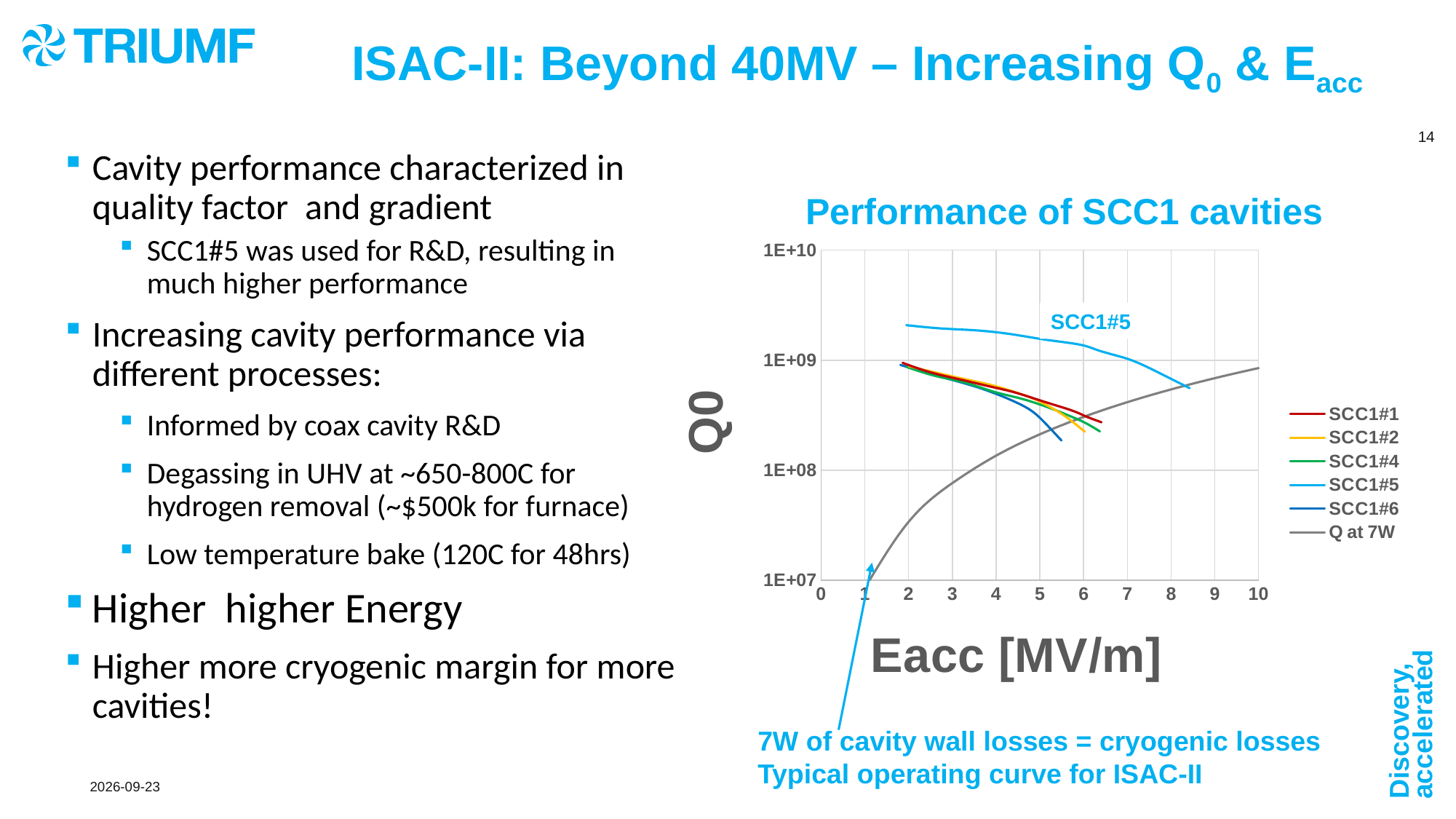
What is the label of the x axis of the "Performance of SCC1 cavities" chart? Eacc [MV/m] What kind of chart is shown under the title "Performance of SCC1 cavities"? line chart In the "Performance of SCC1 cavities" chart, is the Q0 of SCC1#5 at Eacc = 2 MV/m greater or less than 1E+09? greater In the "Performance of SCC1 cavities" chart, is the "Q at 7W" value at Eacc = 10 MV/m greater or less than 1E+08? greater In the "Performance of SCC1 cavities" chart, at Eacc = 4 MV/m, which has the larger Q0: SCC1#5 or SCC1#1? SCC1#5 In the "Performance of SCC1 cavities" chart, does the "Q at 7W" curve rise or fall as Eacc increases? rise How many series does the legend of the "Performance of SCC1 cavities" chart list? 6 Which legend entry in the "Performance of SCC1 cavities" chart is drawn in grey? Q at 7W In the "Performance of SCC1 cavities" chart, is the Q0 of SCC1#1 at Eacc = 6 MV/m greater or less than 1E+09? less Which cavity series in the "Performance of SCC1 cavities" chart has the highest Q0 values? SCC1#5 Which cavity series in the "Performance of SCC1 cavities" chart extends to the highest Eacc? SCC1#5 In the "Performance of SCC1 cavities" chart, does the Q0 of SCC1#5 rise or fall as Eacc increases? fall